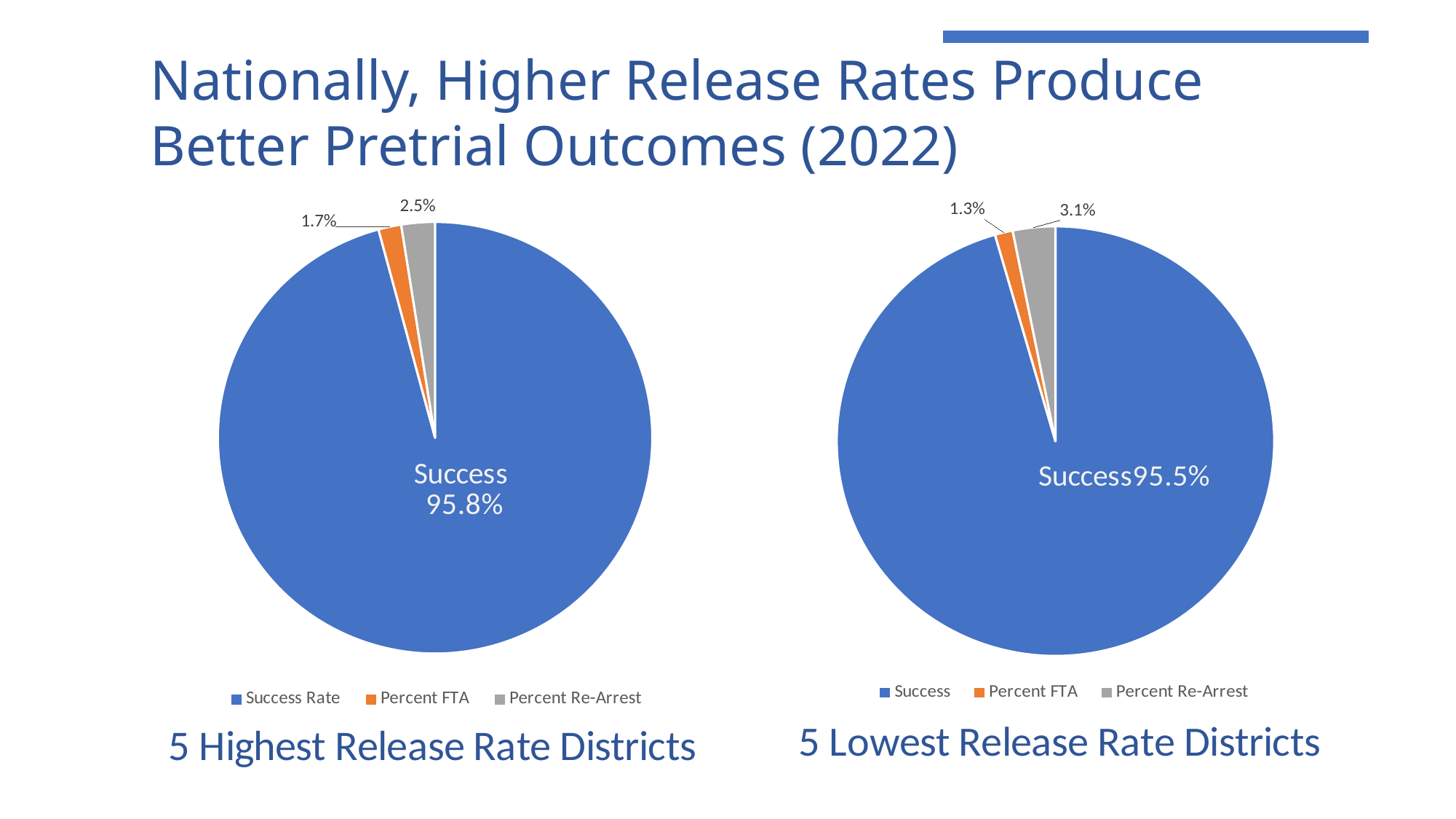
In the 5 Lowest Release Rate Districts chart, what is the difference between Percent Re-Arrest and Percent FTA? 1.8% In the 5 Lowest Release Rate Districts chart, what is the value for Percent FTA? 1.3% In the 5 Lowest Release Rate Districts chart, which category has the largest slice? Success Which chart shows a higher Percent Re-Arrest, the 5 Highest Release Rate Districts chart or the 5 Lowest Release Rate Districts chart? 5 Lowest Release Rate Districts How many entries does the legend of the 5 Lowest Release Rate Districts chart list? 3 In the 5 Highest Release Rate Districts chart, what is the value for Success Rate? 95.8% In the 5 Lowest Release Rate Districts chart, what is the value for Success? 95.5% In the 5 Highest Release Rate Districts chart, which category has the smallest slice? Percent FTA In the 5 Highest Release Rate Districts chart, what is the value for Percent FTA? 1.7% What kind of chart is used for the 5 Highest Release Rate Districts? Pie chart In the 5 Lowest Release Rate Districts chart, what is the value for Percent Re-Arrest? 3.1% In the 5 Highest Release Rate Districts chart, what is the value for Percent Re-Arrest? 2.5%